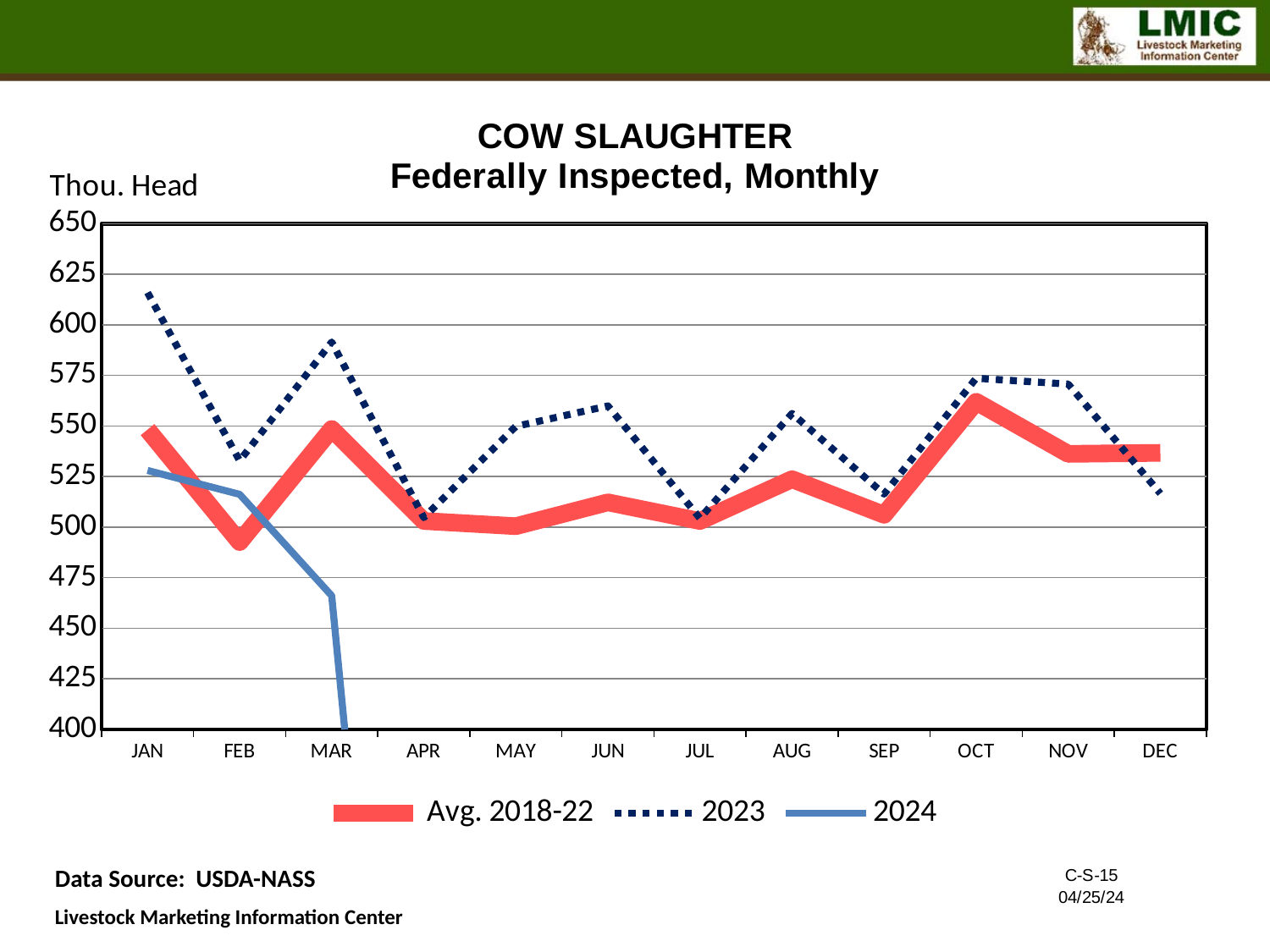
Which month has the highest value for the 2023 series? JAN What kind of chart is shown on the slide? line chart Does the 2024 series rise or fall from JAN to MAR? fall Is the Avg. 2018-22 value for FEB greater or less than 500? less Which month has the lowest value for the Avg. 2018-22 series? FEB What unit label is shown on the y axis? Thou. Head How many series does the legend list? 3 How many months are shown along the x axis? 12 In JAN, which is larger: the 2023 value or the Avg. 2018-22 value? 2023 Is the 2023 value for JAN greater or less than 600? greater Which month has the highest value for the Avg. 2018-22 series? OCT Is the 2024 value for MAR greater or less than 475? less